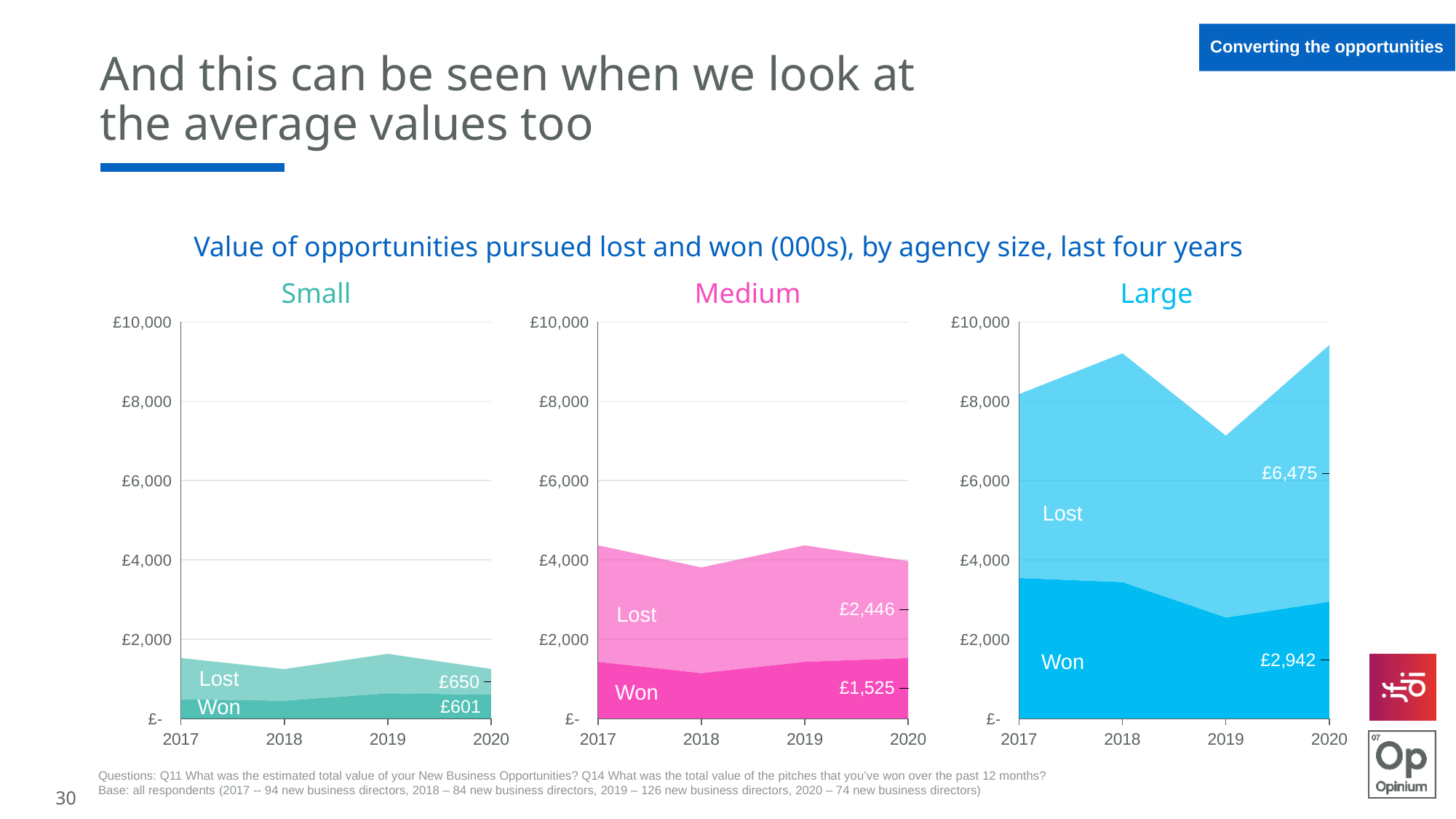
In the Large chart, is the combined value for 2019 greater or less than £8,000? less In the Small chart, which is larger in 2020, Lost or Won? Lost What kind of chart is used for the Small, Medium and Large panels? Stacked area chart In the Large chart, does the Won value rise or fall from 2017 to 2019? Fall In the Medium chart, what is the value for Won in 2020? £1,525 How many series are shown in each chart? 2 How many years are shown on the x axis of each chart? 4 In the Medium chart, is the combined value for 2017 greater or less than £4,000? greater In the Large chart, what is the difference between Lost and Won in 2020? £3,533 In the Medium chart, what is the combined value of Lost and Won in 2020? £3,971 In the Small chart, what is the value for Lost in 2020? £650 In the Large chart, what is the value for Lost in 2020? £6,475